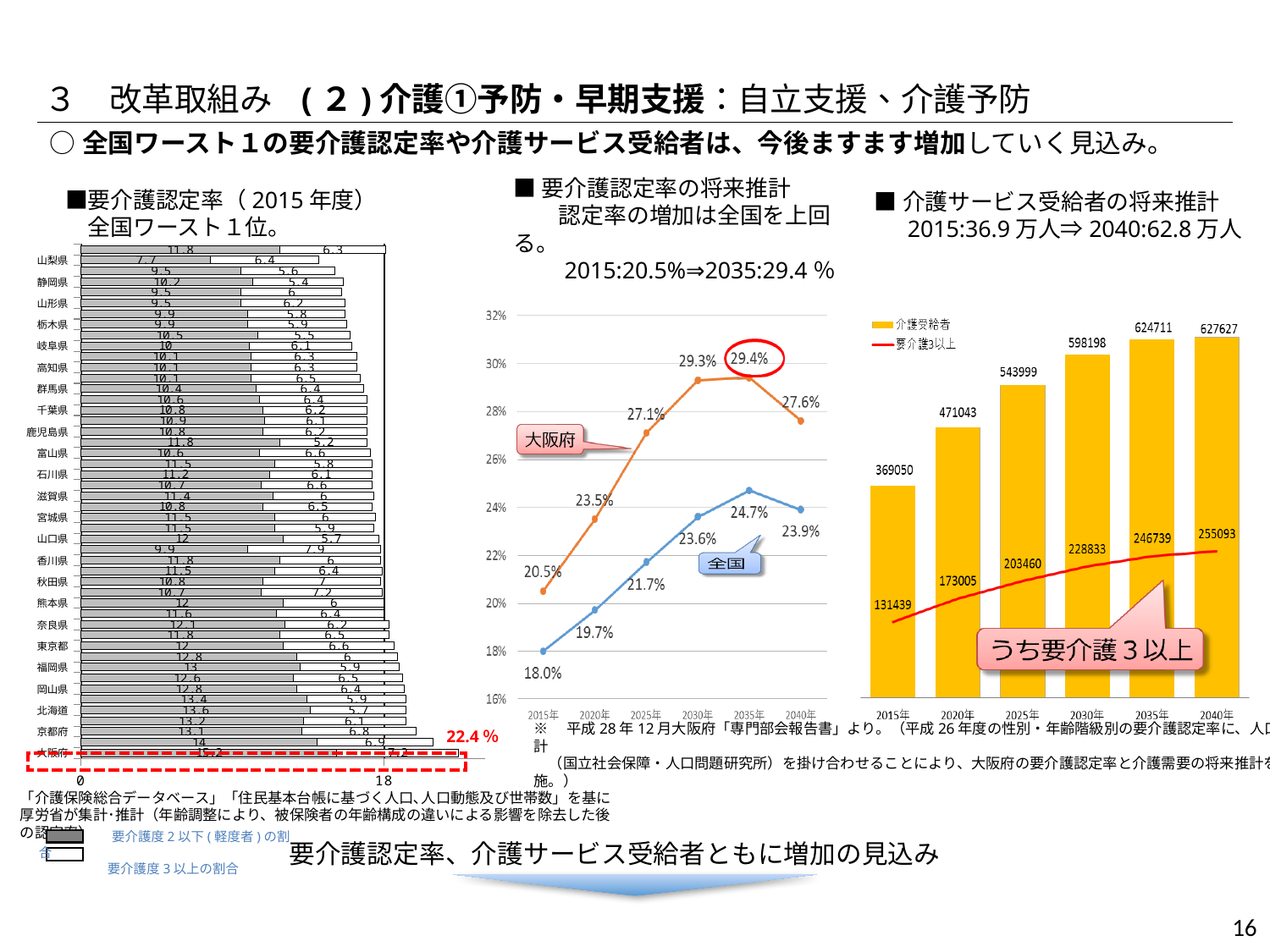
In the middle chart (要介護認定率の将来推計), which year has the highest value for 大阪府? 2035年 In the right chart (介護サービス受給者の将来推計), do the 介護受給者 values rise or fall from 2015年 to 2040年? Rise In the right chart (介護サービス受給者の将来推計), what is the difference between 介護受給者 in 2040年 and 2015年? 258577 In the left chart (要介護認定率 2015年度), what is the total value shown for 大阪府? 22.4% In the middle chart (要介護認定率の将来推計), what kind of chart is it? Line chart In the right chart (介護サービス受給者の将来推計), which year has the lowest value of 介護受給者? 2015年 In the middle chart (要介護認定率の将来推計), what is the value for 全国 in 2015年? 18.0% In the middle chart (要介護認定率の将来推計), what is the value for 大阪府 in 2035年? 29.4% In the right chart (介護サービス受給者の将来推計), what is the value of 介護受給者 in 2025年? 543999 In the middle chart (要介護認定率の将来推計), how many series are shown? 2 In the right chart (介護サービス受給者の将来推計), what is the value of 要介護3以上 in 2040年? 255093 In the middle chart (要介護認定率の将来推計), what is the difference between 大阪府 and 全国 in 2040年? 3.7%